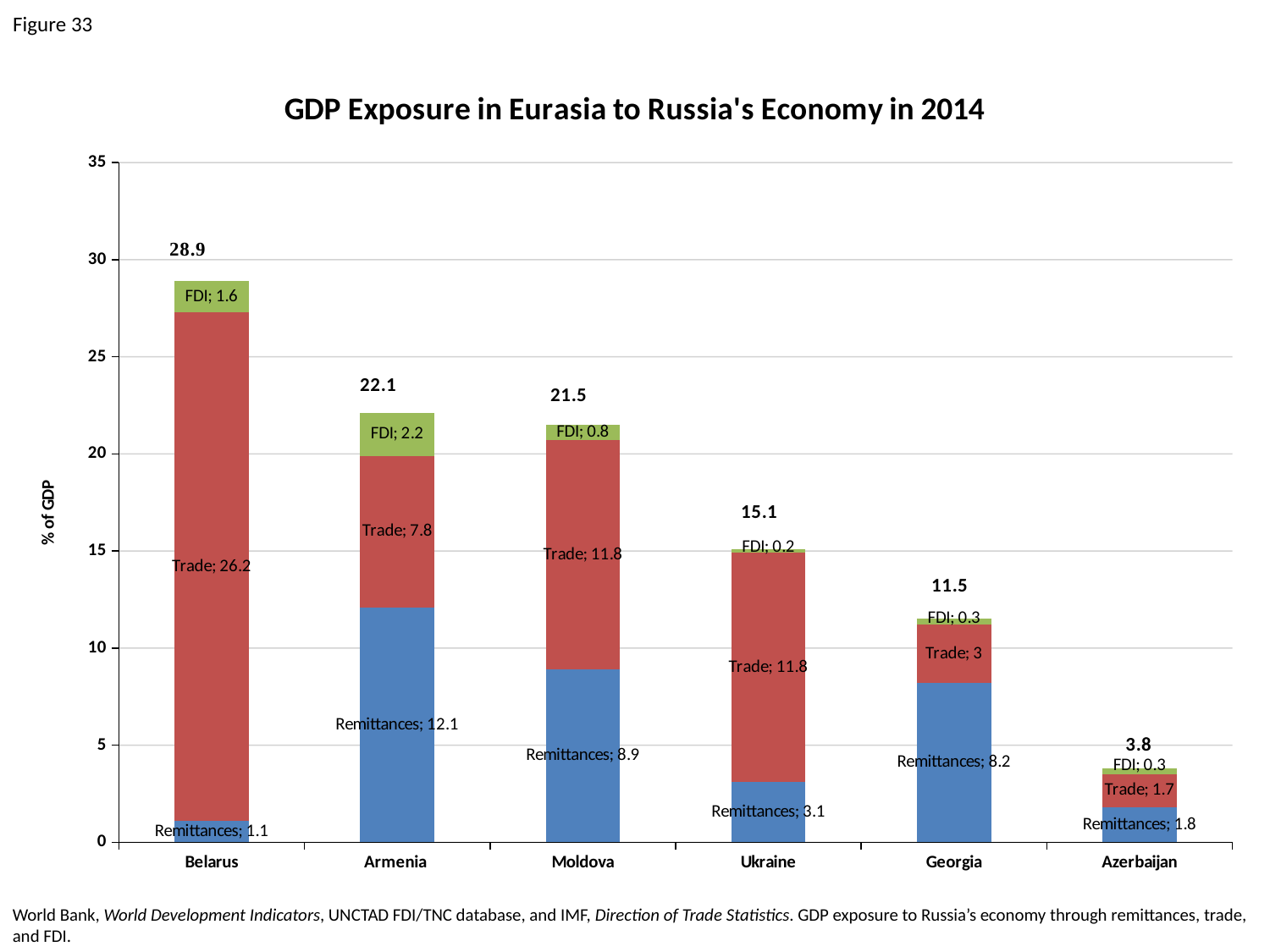
What kind of chart is this? Stacked bar chart Which country has the highest total GDP exposure? Belarus Which is larger, the Remittances value for Georgia or the Remittances value for Moldova? Moldova Do the total values rise or fall from Belarus to Azerbaijan along the x axis? Fall Which country has the lowest total GDP exposure? Azerbaijan What is the Trade value for Moldova? 11.8 What is the difference between the total GDP exposure of Armenia and Moldova? 0.6 What is the FDI value for Georgia? 0.3 What is the Remittances value for Armenia? 12.1 What is the total GDP exposure for Belarus? 28.9 How many countries are shown on the x axis? 6 What is the title of the chart? GDP Exposure in Eurasia to Russia's Economy in 2014